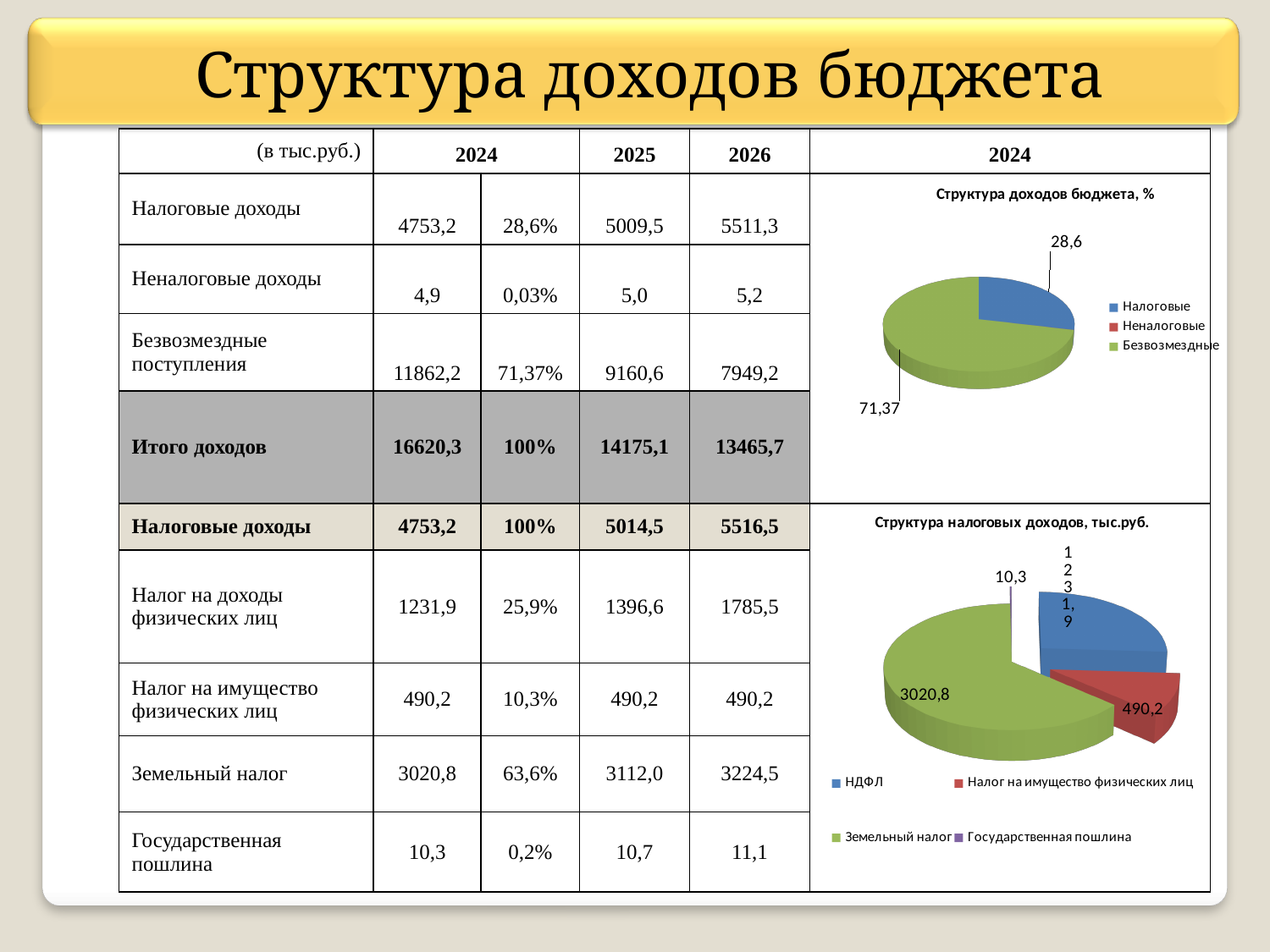
In the chart titled "Структура доходов бюджета, %", how many entries does the legend list? 3 In the chart titled "Структура налоговых доходов, тыс.руб.", what value is shown for Налог на имущество физических лиц? 490,2 In the chart titled "Структура налоговых доходов, тыс.руб.", which category has the smallest slice? Государственная пошлина In the chart titled "Структура доходов бюджета, %", which category has the largest slice? Безвозмездные In the chart titled "Структура налоговых доходов, тыс.руб.", what is the difference between the values for Земельный налог and Налог на имущество физических лиц? 2530,6 In the chart titled "Структура доходов бюджета, %", what value is shown for the Безвозмездные slice? 71,37 In the chart titled "Структура налоговых доходов, тыс.руб.", how many entries does the legend list? 4 In the chart titled "Структура налоговых доходов, тыс.руб.", what value is shown for Государственная пошлина? 10,3 In the chart titled "Структура доходов бюджета, %", what value is shown for the Налоговые slice? 28,6 In the chart titled "Структура налоговых доходов, тыс.руб.", which category has the largest slice? Земельный налог In the chart titled "Структура налоговых доходов, тыс.руб.", what value is shown for Земельный налог? 3020,8 What kind of chart is the one titled "Структура доходов бюджета, %"? Pie chart